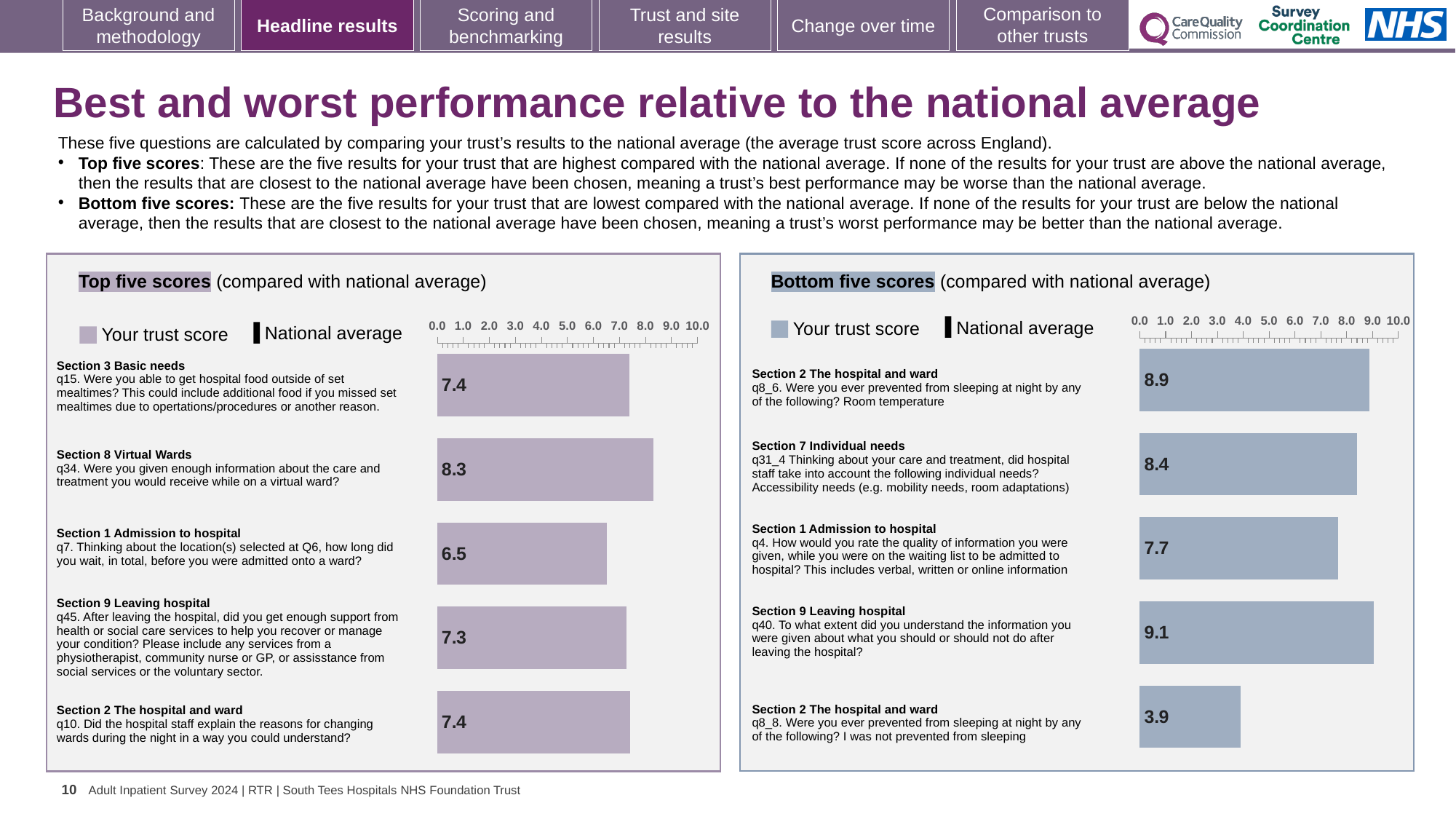
In the 'Top five scores' chart, which question has the highest trust score? q34 (Section 8 Virtual Wards) In the 'Bottom five scores' chart, what is the difference between the trust scores for q40 and q8_8? 5.2 In the 'Bottom five scores' chart, which has the larger trust score: q8_6 (room temperature) or q31_4 (accessibility needs)? q8_6 (room temperature) In the 'Top five scores' chart, what is the trust score for q7 (how long you waited before being admitted onto a ward)? 6.5 How many entries does the legend of the 'Top five scores' chart list? 2 In the 'Top five scores' chart, what is the difference between the trust scores for q34 and q7? 1.8 What type of chart is used in the 'Bottom five scores' panel? Bar chart In the 'Top five scores' chart, what is the trust score for q34 (information about care on a virtual ward)? 8.3 In the 'Bottom five scores' chart, what is the trust score for q8_8 (I was not prevented from sleeping)? 3.9 How many bars are plotted in the 'Top five scores' chart? 5 In the 'Bottom five scores' chart, what is the trust score for q40 (understanding information about what to do after leaving hospital)? 9.1 In the 'Bottom five scores' chart, which question has the lowest trust score? q8_8 (Section 2 The hospital and ward)